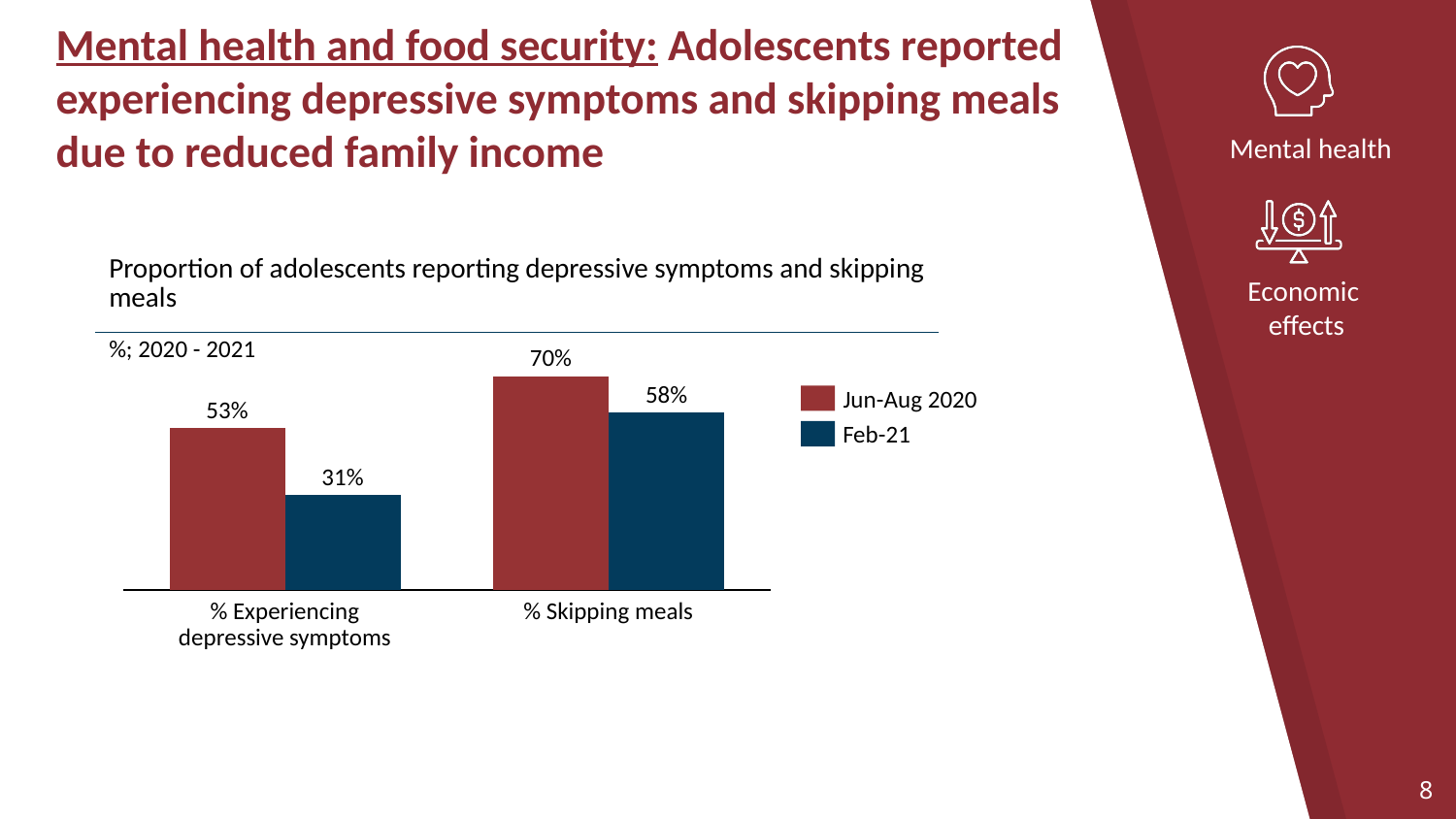
How many series does the legend list? 2 What kind of chart is shown on the slide? Bar chart By how many percentage points did the share of adolescents experiencing depressive symptoms fall from Jun-Aug 2020 to Feb-21? 22 percentage points What percentage of adolescents reported experiencing depressive symptoms in Feb-21? 31% Which category has the highest value in the Jun-Aug 2020 series? % Skipping meals Which is larger: the Feb-21 value for % Skipping meals or the Jun-Aug 2020 value for % Experiencing depressive symptoms? Feb-21 value for % Skipping meals Which category has the lowest value in the Feb-21 series? % Experiencing depressive symptoms What is the difference between the Jun-Aug 2020 and Feb-21 values for % Skipping meals? 12 percentage points What percentage of adolescents reported experiencing depressive symptoms in Jun-Aug 2020? 53% What percentage of adolescents reported skipping meals in Jun-Aug 2020? 70% Which colour represents the Feb-21 series in the chart? Dark blue What percentage of adolescents reported skipping meals in Feb-21? 58%